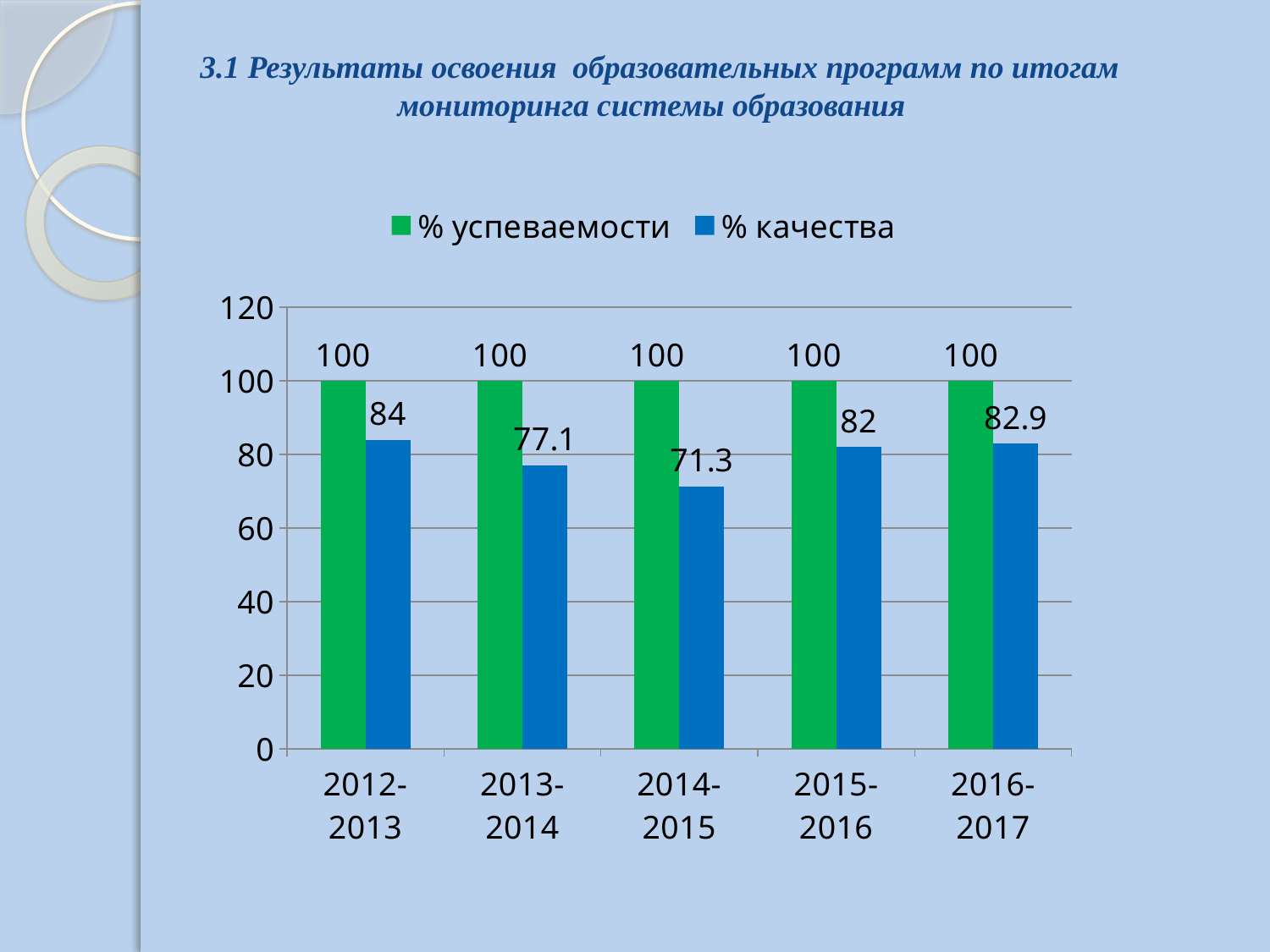
What is the value of % качества for 2016-2017? 82.9 Which is larger, % качества in 2015-2016 or in 2016-2017? 2016-2017 What kind of chart is shown on the slide? bar chart Which year has the highest % качества? 2012-2013 Which year has the lowest % качества? 2014-2015 Which colour represents % успеваемости in the legend? green What is the value of % успеваемости for 2015-2016? 100 How many series does the legend list? 2 How many academic years are shown on the x axis? 5 What is the difference between % успеваемости and % качества in 2013-2014? 22.9 What is the value of % качества for 2012-2013? 84 What is the value of % качества for 2014-2015? 71.3